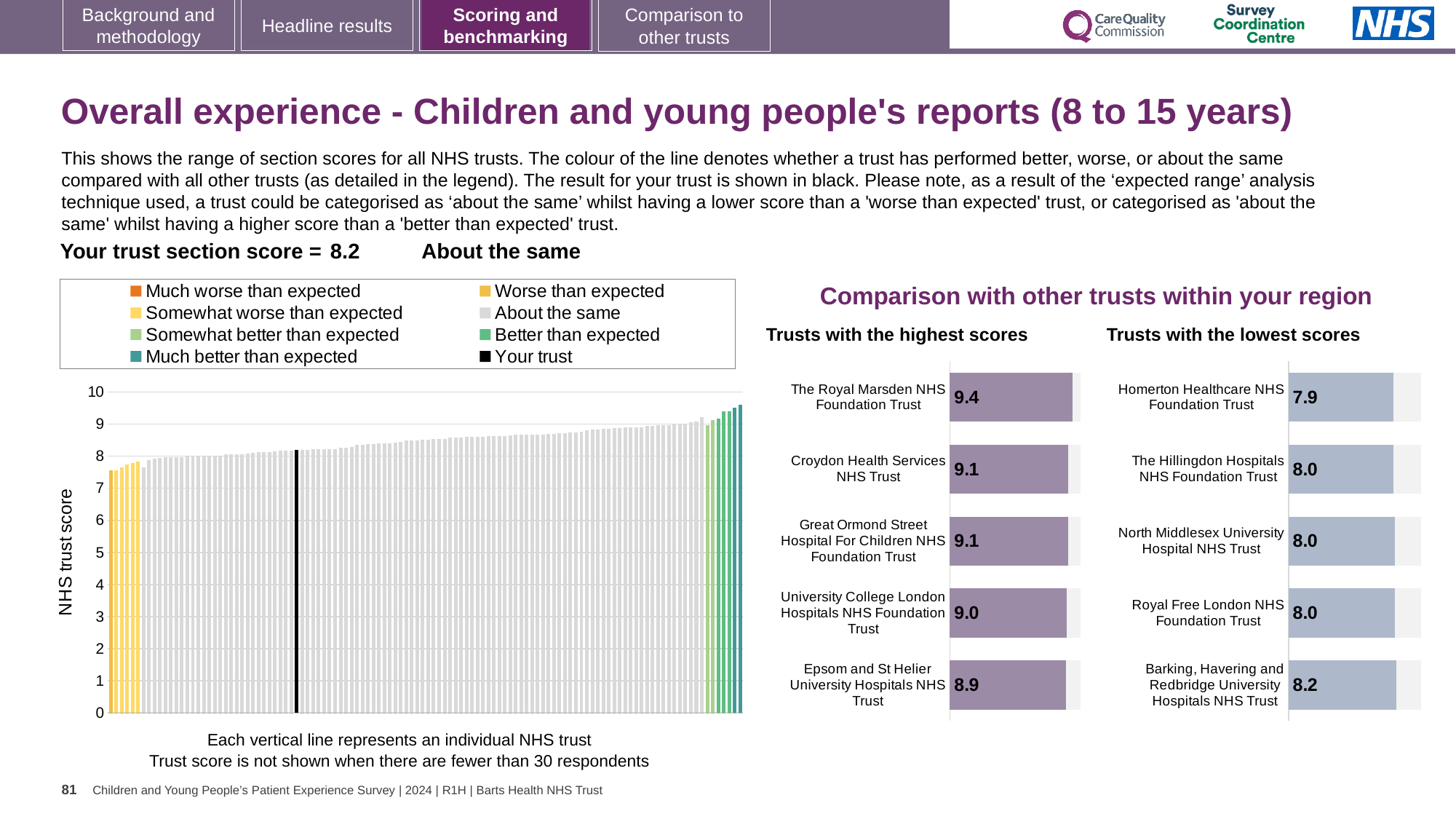
How many entries does the legend of the left-hand NHS trust score chart list? 8 What kind of chart is the large chart on the left showing NHS trust scores? bar chart In the 'Trusts with the highest scores' chart, what is the score for The Royal Marsden NHS Foundation Trust? 9.4 In the 'Trusts with the lowest scores' chart, what is the score for Barking, Havering and Redbridge University Hospitals NHS Trust? 8.2 In the 'Trusts with the lowest scores' chart, what is the difference between the scores of Barking, Havering and Redbridge University Hospitals NHS Trust and Homerton Healthcare NHS Foundation Trust? 0.3 How many trusts are shown in the 'Trusts with the lowest scores' chart? 5 In the 'Trusts with the highest scores' chart, what is the score for Epsom and St Helier University Hospitals NHS Trust? 8.9 What is the label on the vertical axis of the left-hand chart? NHS trust score In the 'Trusts with the highest scores' chart, what is the difference between the scores of The Royal Marsden NHS Foundation Trust and Epsom and St Helier University Hospitals NHS Trust? 0.5 In the 'Trusts with the lowest scores' chart, which trust has the lowest score? Homerton Healthcare NHS Foundation Trust In the 'Trusts with the highest scores' chart, which trust has the highest score? The Royal Marsden NHS Foundation Trust In the 'Trusts with the highest scores' chart, which has the larger score: Croydon Health Services NHS Trust or University College London Hospitals NHS Foundation Trust? Croydon Health Services NHS Trust